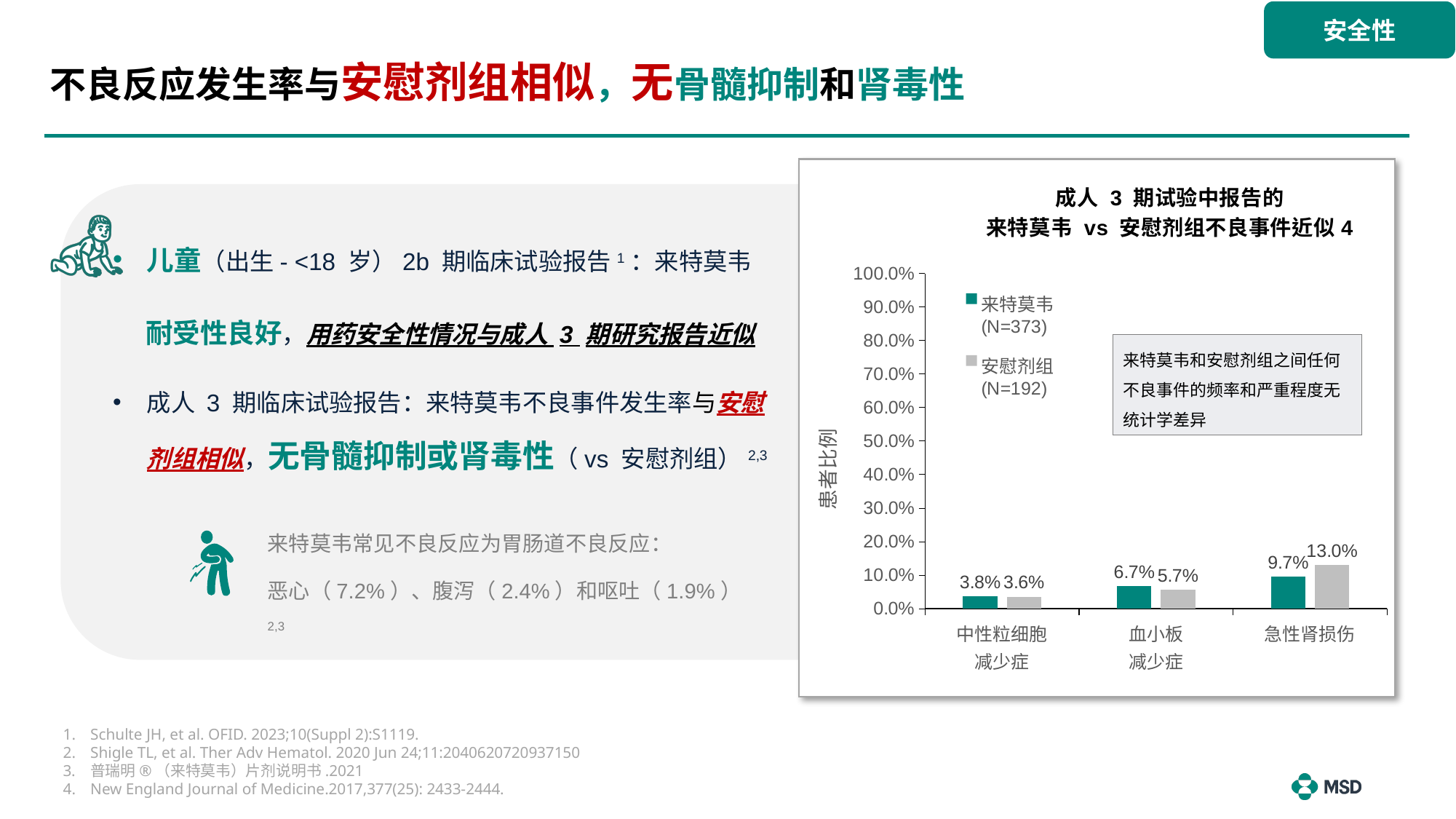
How many categories are shown on the x axis of the chart? 3 Which category has the highest value for 来特莫韦? 急性肾损伤 What is the value for 来特莫韦 in the 中性粒细胞减少症 category? 3.8% In the 急性肾损伤 category, which series has the larger value, 来特莫韦 or 安慰剂组? 安慰剂组 How many series does the chart legend list? 2 Is the value for 安慰剂组 in 急性肾损伤 greater or less than 10.0%? greater What is the value for 安慰剂组 in the 血小板减少症 category? 5.7% What is the sample size (N) shown in the legend for 来特莫韦? N=373 What is the value for 安慰剂组 in the 急性肾损伤 category? 13.0% What is the difference between 安慰剂组 and 来特莫韦 in the 急性肾损伤 category? 3.3% Which category has the lowest value for 安慰剂组? 中性粒细胞减少症 What type of chart is shown on the slide? Bar chart